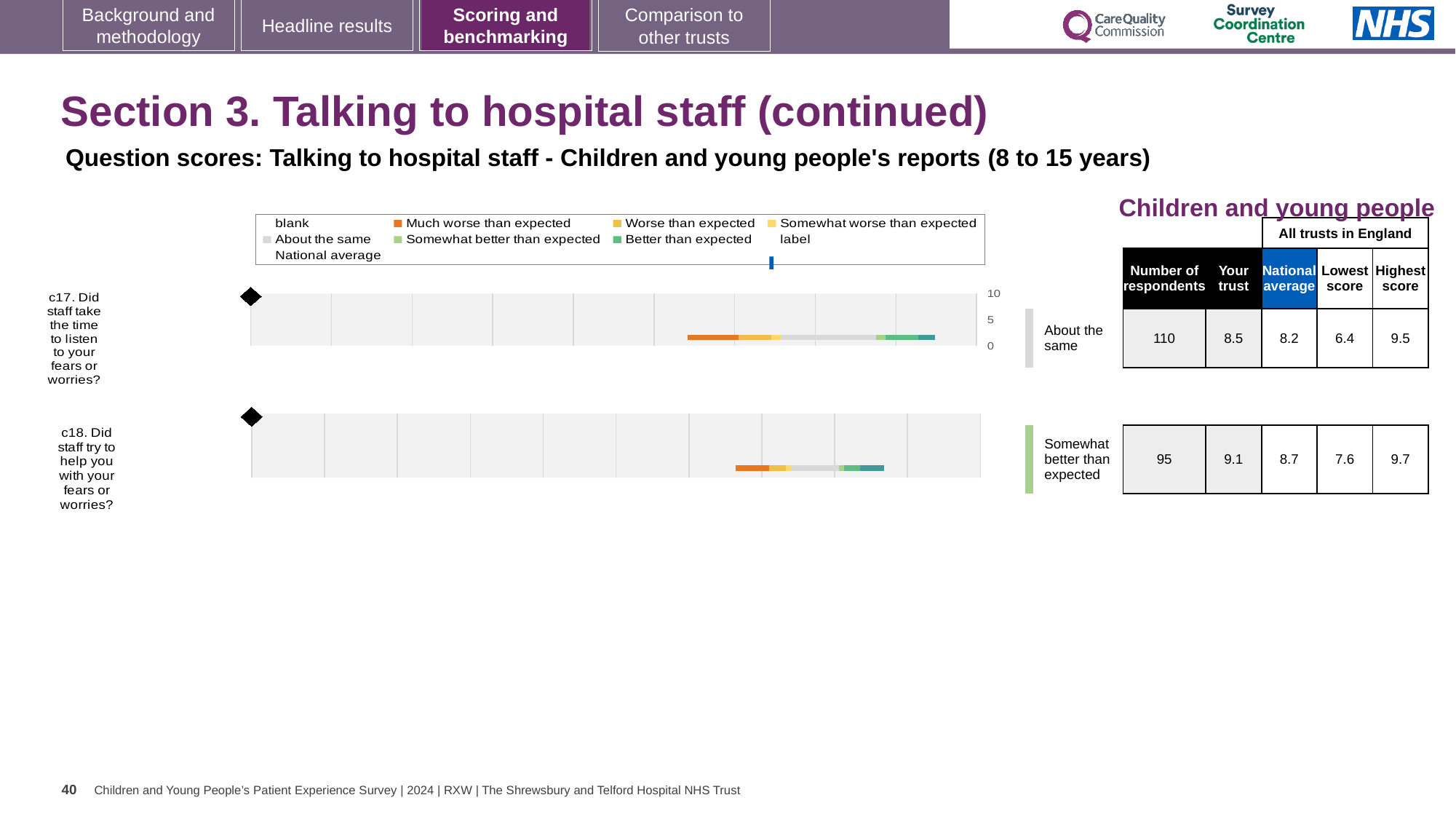
How many questions (c17 and c18) are plotted on the slide? 2 What is the highest score among all trusts in England for c18? 9.7 What is the difference between the highest and lowest scores for c17? 3.1 What is the difference between the trust's score and the national average for c18? 0.4 Which benchmark category is the trust's c18 score placed in? Somewhat better than expected Which question has the higher trust score, c17 or c18? c18 How many respondents answered c17? 110 What is the national average score for c17? 8.2 What is the trust's score for c18 'Did staff try to help you with your fears or worries?' 9.1 What kind of chart is used to show the question scores for c17 and c18? bar chart What is the trust's score for c17 'Did staff take the time to listen to your fears or worries?' 8.5 Which benchmark category is the trust's c17 score placed in? About the same